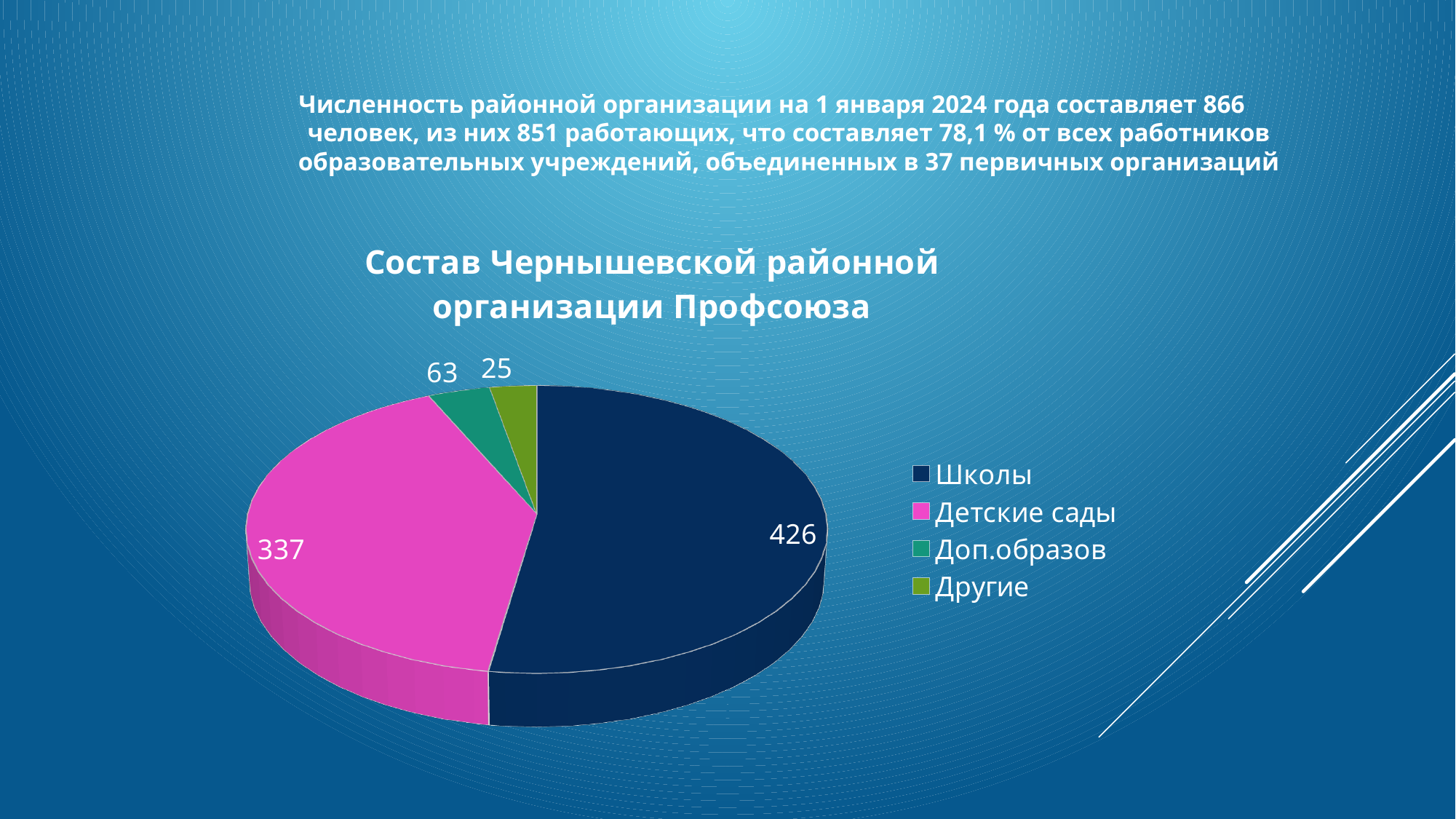
What is the difference between the values for Школы and Детские сады? 89 What is the value for Школы in the pie chart? 426 What is the total of all the slices in the pie chart? 851 What is the value for Другие in the pie chart? 25 Which category has the largest slice in the pie chart? Школы What kind of chart is shown on the slide? Pie chart How many categories does the pie chart show? 4 What is the title of the pie chart? Состав Чернышевской районной организации Профсоюза What is the value for Детские сады in the pie chart? 337 Which is larger, the value for Доп.образов or the value for Другие? Доп.образов Which category has the smallest slice in the pie chart? Другие What is the value for Доп.образов in the pie chart? 63